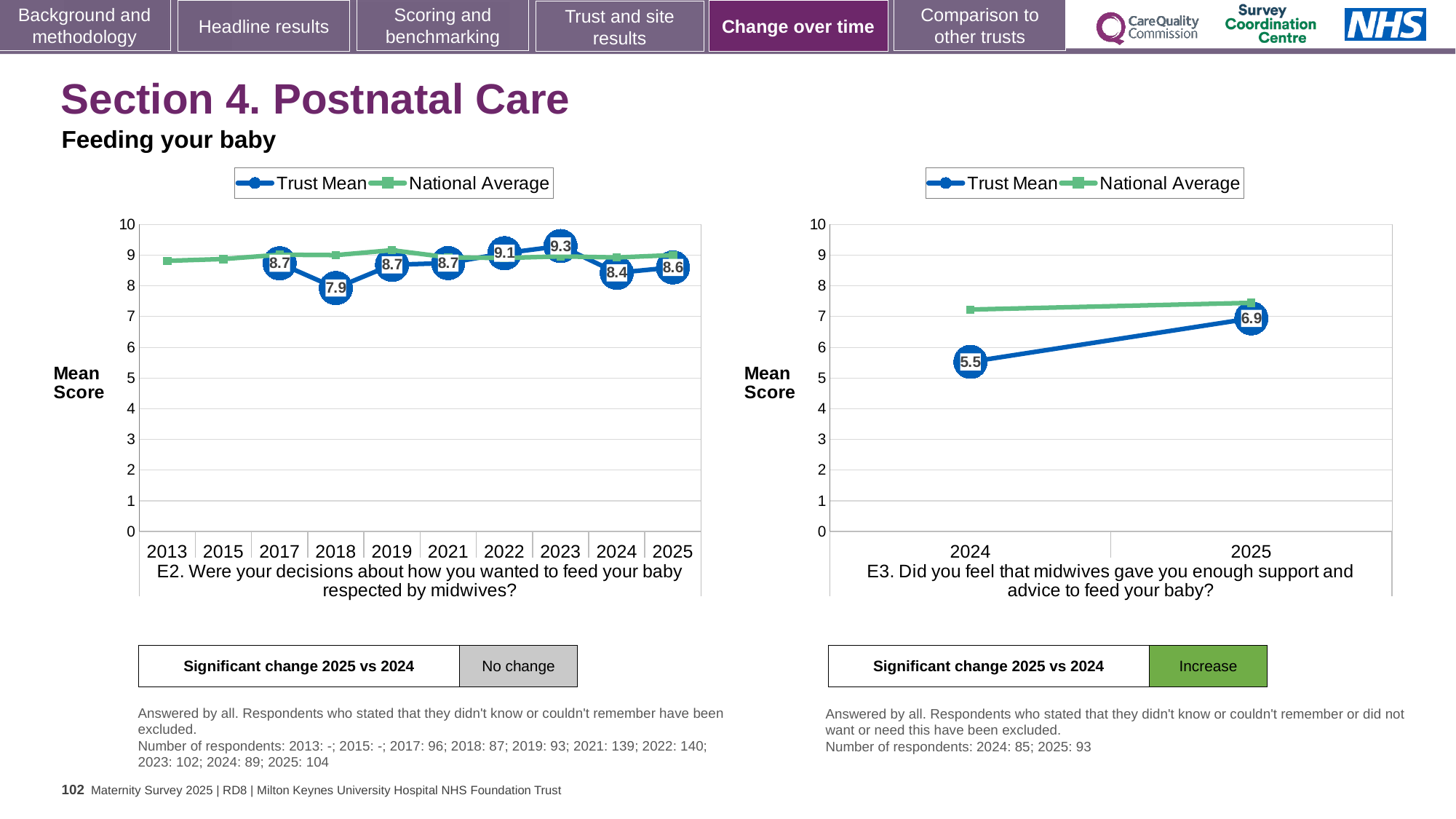
In the left chart (E2), which year has the highest Trust Mean? 2023 How many series does the legend of the right chart (E3) list? 2 What kind of chart is the right chart (E3)? Line chart In the right chart (E3), what is the difference between the Trust Mean for 2025 and 2024? 1.4 In the left chart (E2), what is the Trust Mean for 2018? 7.9 In the left chart (E2), which year has the lowest Trust Mean? 2018 In the right chart (E3), does the Trust Mean rise or fall from 2024 to 2025? Rise In the left chart (E2), what is the Trust Mean for 2023? 9.3 How many years are shown on the x axis of the left chart (E2)? 10 In the left chart (E2), is the Trust Mean higher in 2022 or in 2024? 2022 In the right chart (E3), what is the Trust Mean for 2025? 6.9 In the right chart (E3), is the National Average for 2024 greater or less than 7? greater